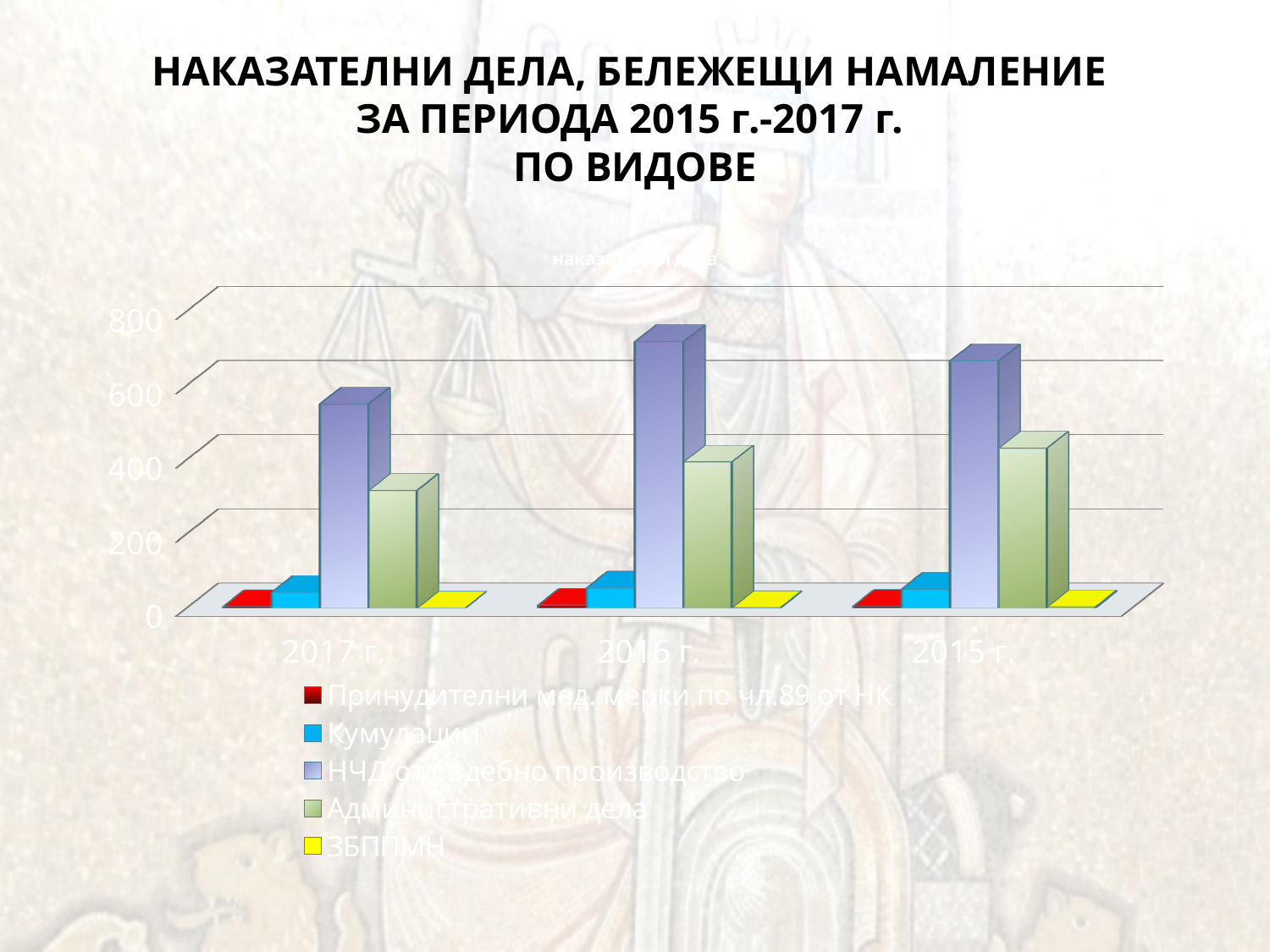
In which year is the value for Административни дела the lowest? 2017 г. How many series does the chart legend list? 5 In which year is the value for НЧД от съдебно производство the highest? 2016 г. Moving left to right along the x axis (2017 г. to 2015 г.), do the values for Административни дела rise or fall? rise How many year categories are shown on the x axis of the chart? 3 Which colour represents ЗБППМН in the chart legend? yellow Is the value for Административни дела in 2017 г. greater or less than 400? less Is the value for НЧД от съдебно производство in 2017 г. greater or less than 400? greater What kind of chart is shown on the slide? bar chart Is the value for НЧД от съдебно производство in 2016 г. greater or less than 600? greater In 2016 г., which is larger: НЧД от съдебно производство or Административни дела? НЧД от съдебно производство